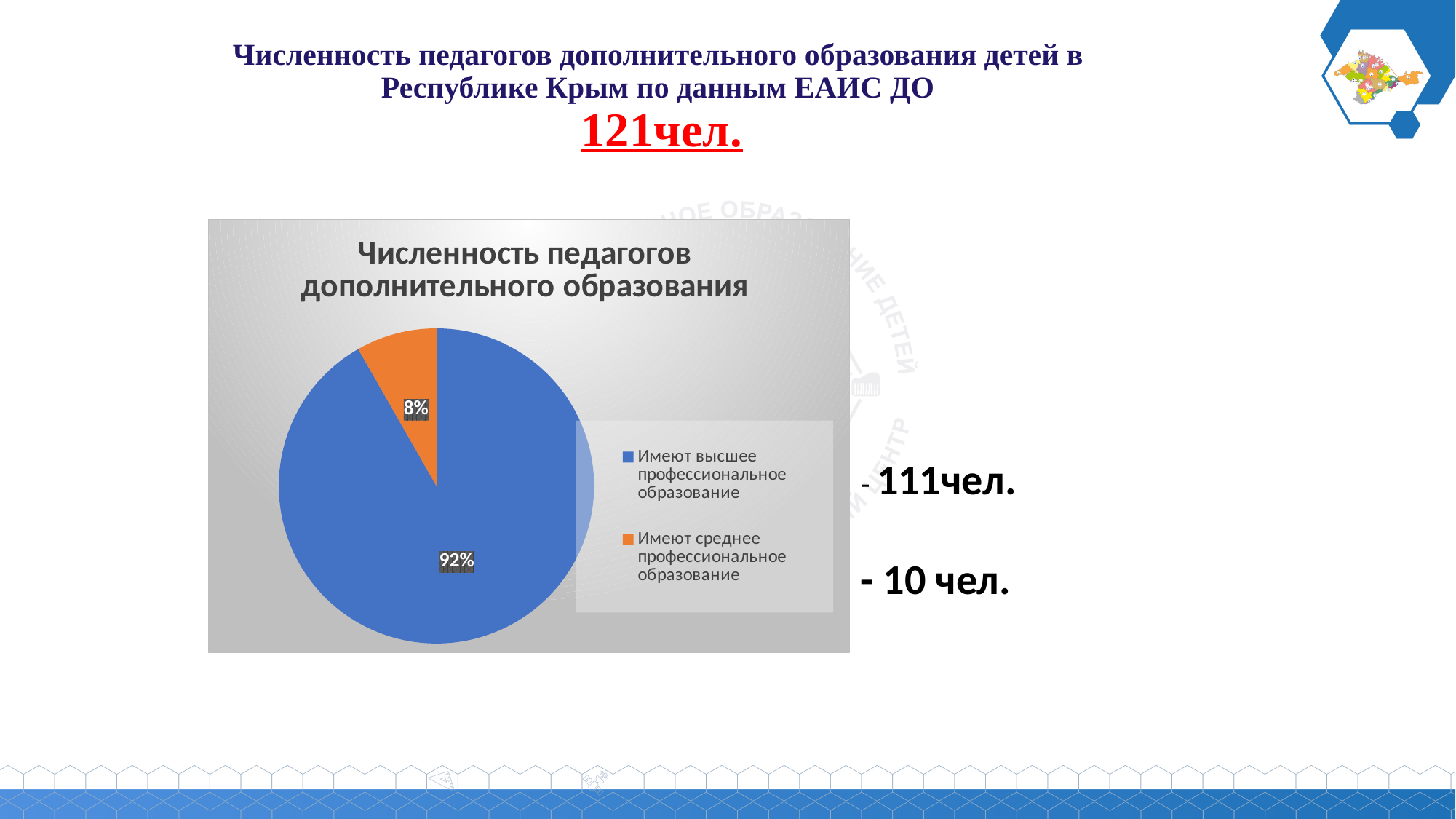
What share of the pie is labelled 'Имеют высшее профессиональное образование'? 92% What colour is the slice for 'Имеют среднее профессиональное образование'? orange What kind of chart is shown on the slide? pie chart What is the difference in percentage points between the 'Имеют высшее профессиональное образование' slice and the 'Имеют среднее профессиональное образование' slice? 84 How many entries does the legend list? 2 Which slice is larger: 'Имеют высшее профессиональное образование' or 'Имеют среднее профессиональное образование'? Имеют высшее профессиональное образование What share of the pie is labelled 'Имеют среднее профессиональное образование'? 8% How many slices does the pie chart have? 2 Which category has the smallest slice of the pie? Имеют среднее профессиональное образование Which category has the largest slice of the pie? Имеют высшее профессиональное образование What is the title of the chart? Численность педагогов дополнительного образования